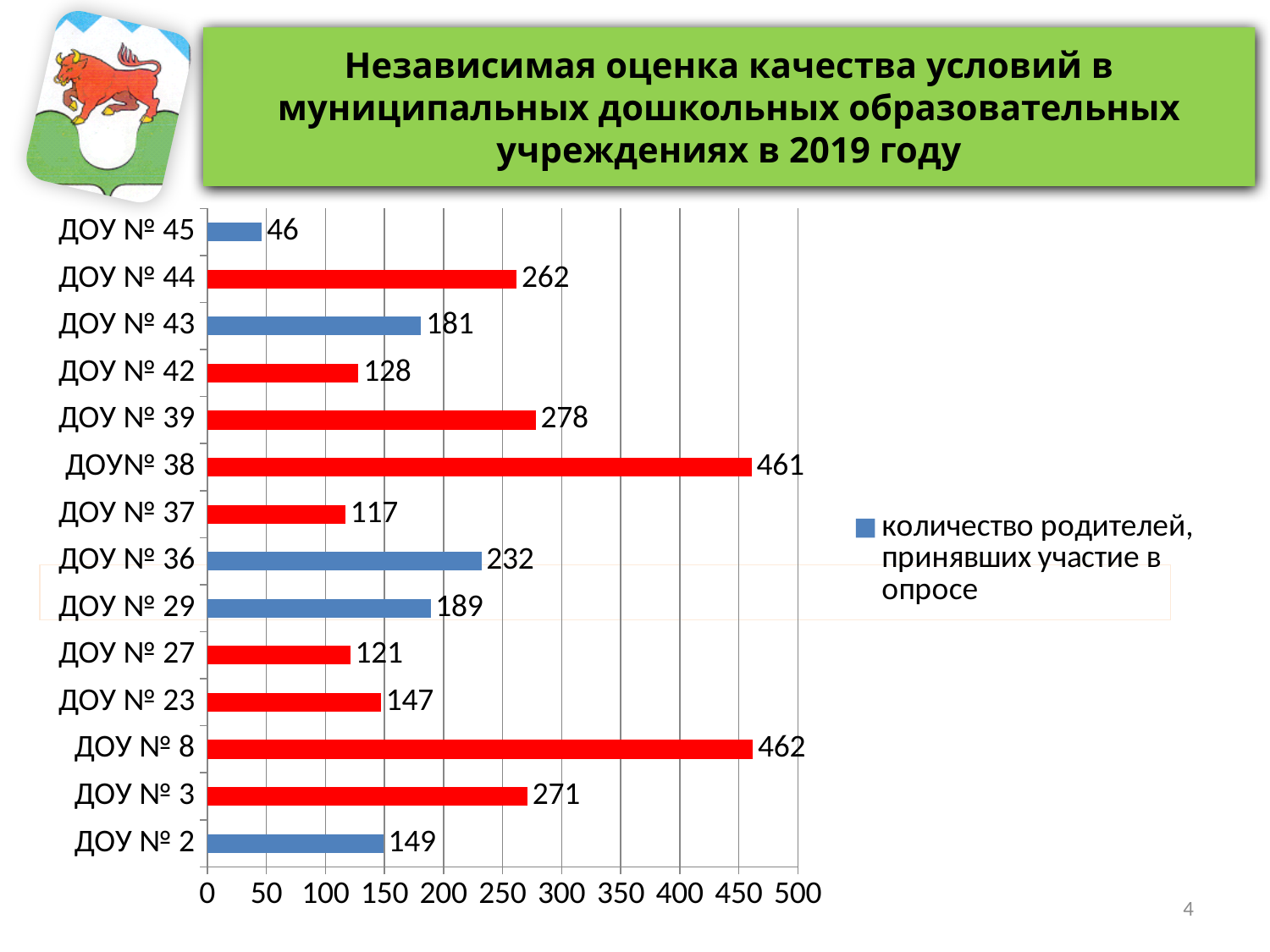
What is the value for ДОУ № 2? 149 Which is larger, the value for ДОУ № 3 or the value for ДОУ № 29? ДОУ № 3 What is the difference between the values for ДОУ № 43 and ДОУ № 45? 135 How many categories are shown on the chart? 14 Is the value for ДОУ № 27 greater or less than 150? less How many series does the legend list? 1 What kind of chart is shown on the slide? bar chart Which is larger, the value for ДОУ № 37 or the value for ДОУ № 23? ДОУ № 23 What is the value for ДОУ № 36? 232 What is the value for ДОУ № 44? 262 Which category has the lowest value? ДОУ № 45 What is the difference between the values for ДОУ № 39 and ДОУ № 42? 150